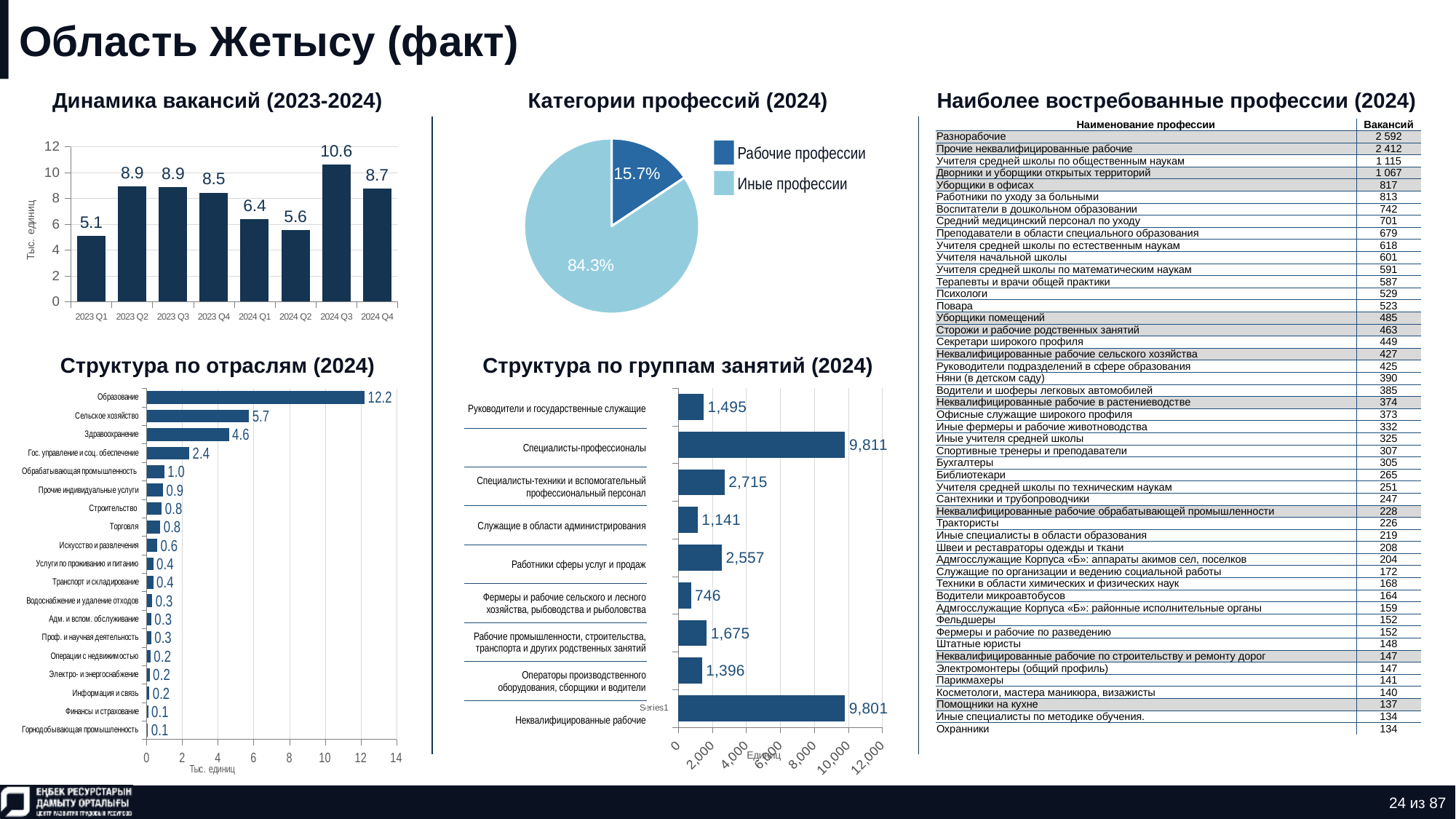
In the chart 'Динамика вакансий (2023-2024)', which quarter has the lowest value? 2023 Q1 In the chart 'Категории профессий (2024)', what share of the pie is 'Рабочие профессии'? 15.7% In the chart 'Динамика вакансий (2023-2024)', do the values rise or fall from 2024 Q1 to 2024 Q3? rise In the chart 'Динамика вакансий (2023-2024)', how many quarters are plotted? 8 In the chart 'Структура по отраслям (2024)', what is the value for 'Образование'? 12.2 In the chart 'Структура по группам занятий (2024)', which group has the lowest value? Фермеры и рабочие сельского и лесного хозяйства, рыбоводства и рыболовства In the chart 'Структура по отраслям (2024)', which is larger: 'Сельское хозяйство' or 'Здравоохранение'? Сельское хозяйство In the chart 'Динамика вакансий (2023-2024)', what is the difference between the values for 2024 Q3 and 2024 Q2? 5.0 In the chart 'Динамика вакансий (2023-2024)', what is the value for 2024 Q3? 10.6 In the chart 'Категории профессий (2024)', how many series does the legend list? 2 What kind of chart is 'Категории профессий (2024)'? pie chart In the chart 'Структура по группам занятий (2024)', what is the value for 'Специалисты-профессионалы'? 9,811